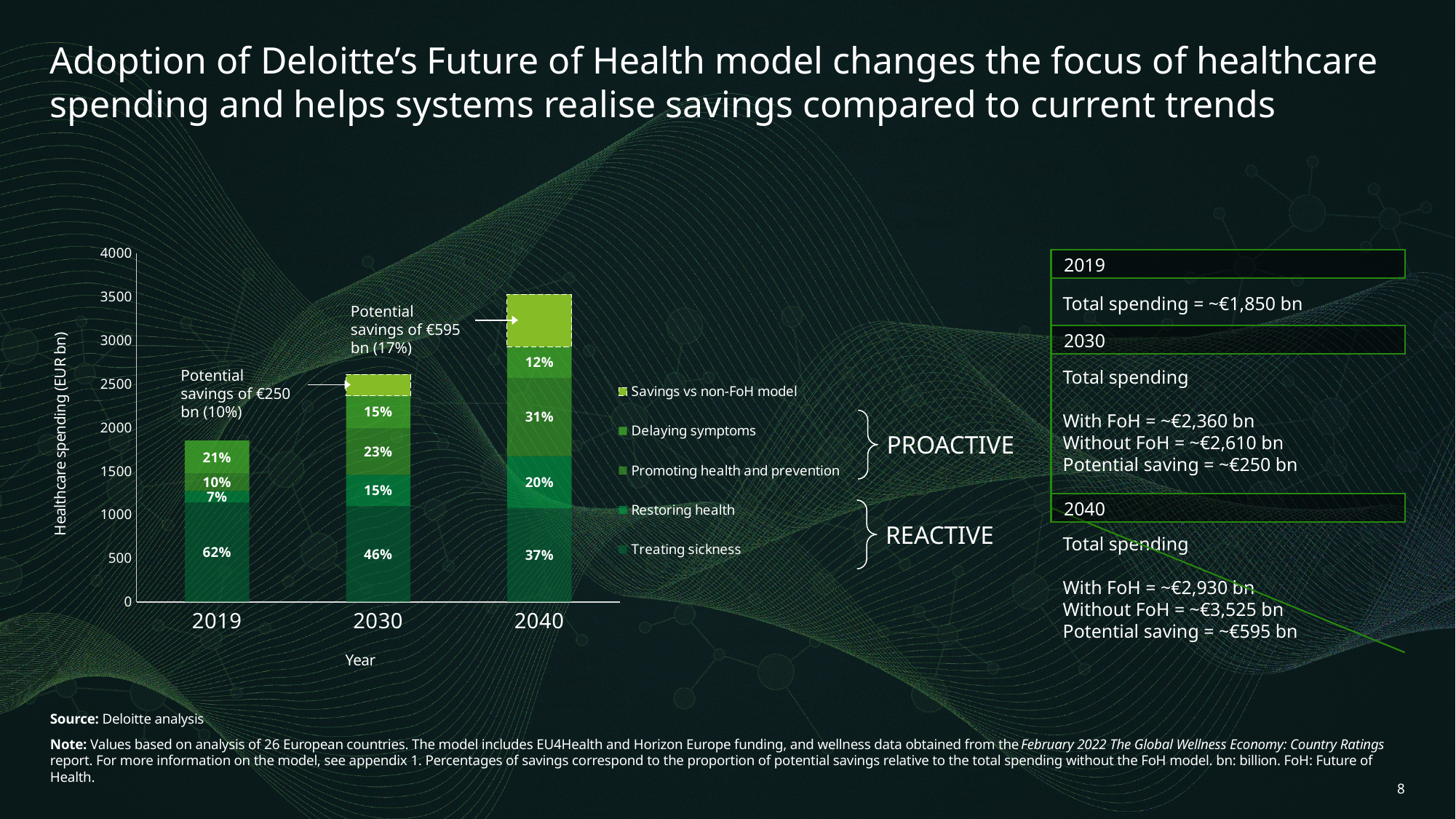
Does the Treating sickness percentage rise or fall from 2019 to 2040? Fall What is the difference in percentage points between the Treating sickness share in 2019 and in 2040? 25 percentage points What kind of chart is shown on the slide? Stacked bar chart What percentage of healthcare spending is labelled for Treating sickness in 2019? 62% What percentage is labelled for Treating sickness in 2040? 37% What is the label of the y axis of the chart? Healthcare spending (EUR bn) Which year has the highest labelled percentage for Treating sickness? 2019 Is the top of the 2040 bar (including savings) greater or less than 3000 on the y axis? greater What percentage is labelled for Delaying symptoms in 2030? 15% What percentage is labelled for Promoting health and prevention in 2040? 31% How many series does the chart legend list? 5 How many years are shown on the x axis of the chart? 3